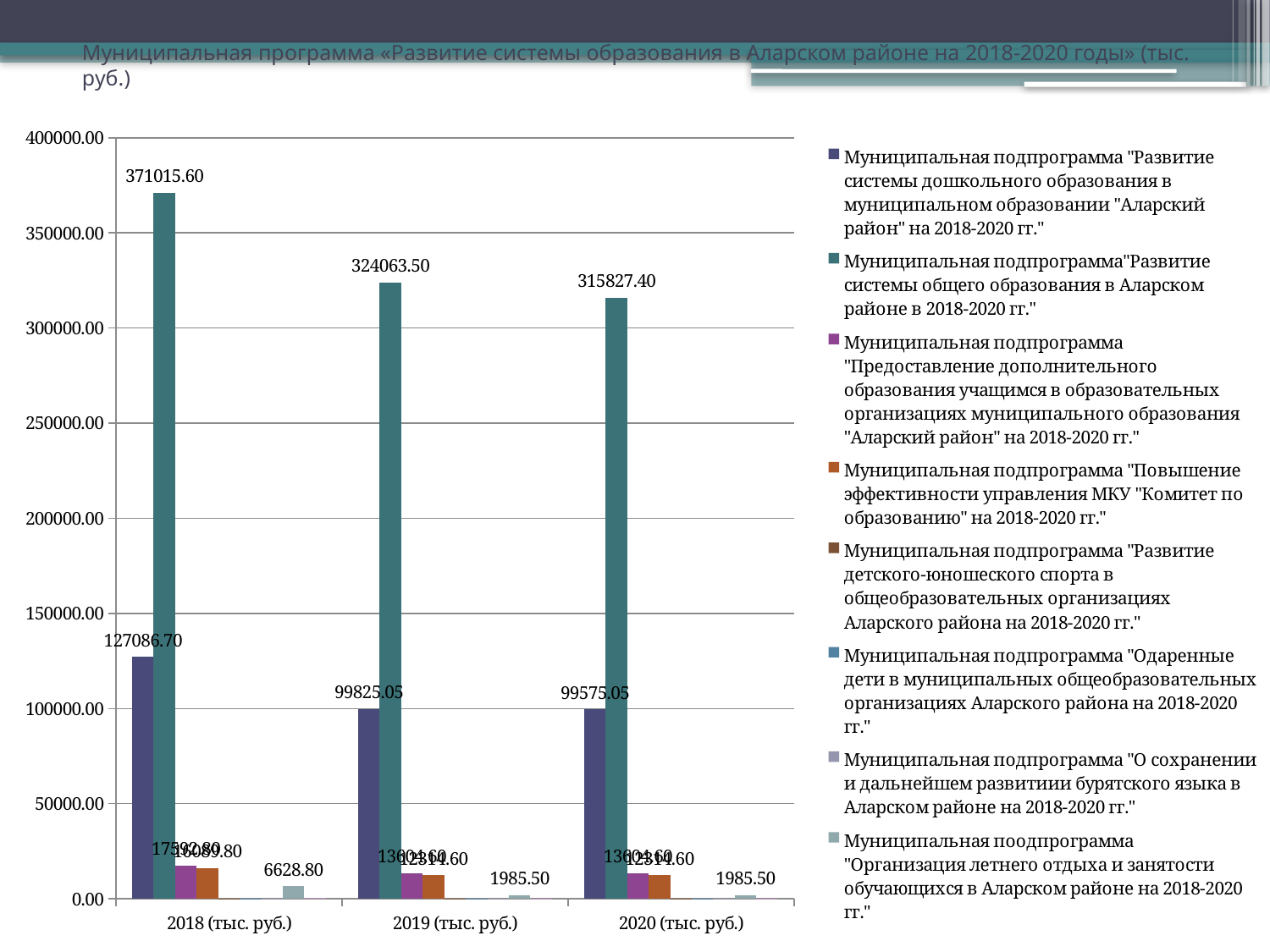
What is the difference between the 2018 and 2019 values for the subprogram "Развитие системы общего образования"? 46952.10 Which is larger: the 2018 value for "Развитие системы дошкольного образования" or the 2020 value for the same subprogram? 2018 (тыс. руб.) What type of chart is shown on the slide? bar chart In which year is the value for the subprogram "Развитие системы общего образования" highest? 2018 (тыс. руб.) How many year categories are shown on the x axis? 3 Is the 2020 value for the subprogram "Развитие системы дошкольного образования" greater or less than 100000.00? less How many series does the legend list? 8 What is the value for the subprogram "Организация летнего отдыха и занятости обучающихся" in 2018 (тыс. руб.)? 6628.80 Does the value for the subprogram "Развитие системы общего образования" rise or fall from 2018 to 2020? fall What is the value for the subprogram "Развитие системы общего образования" in 2020 (тыс. руб.)? 315827.40 What is the value for the subprogram "Развитие системы общего образования" in 2018 (тыс. руб.)? 371015.60 What is the value for the subprogram "Развитие системы дошкольного образования" in 2019 (тыс. руб.)? 99825.05